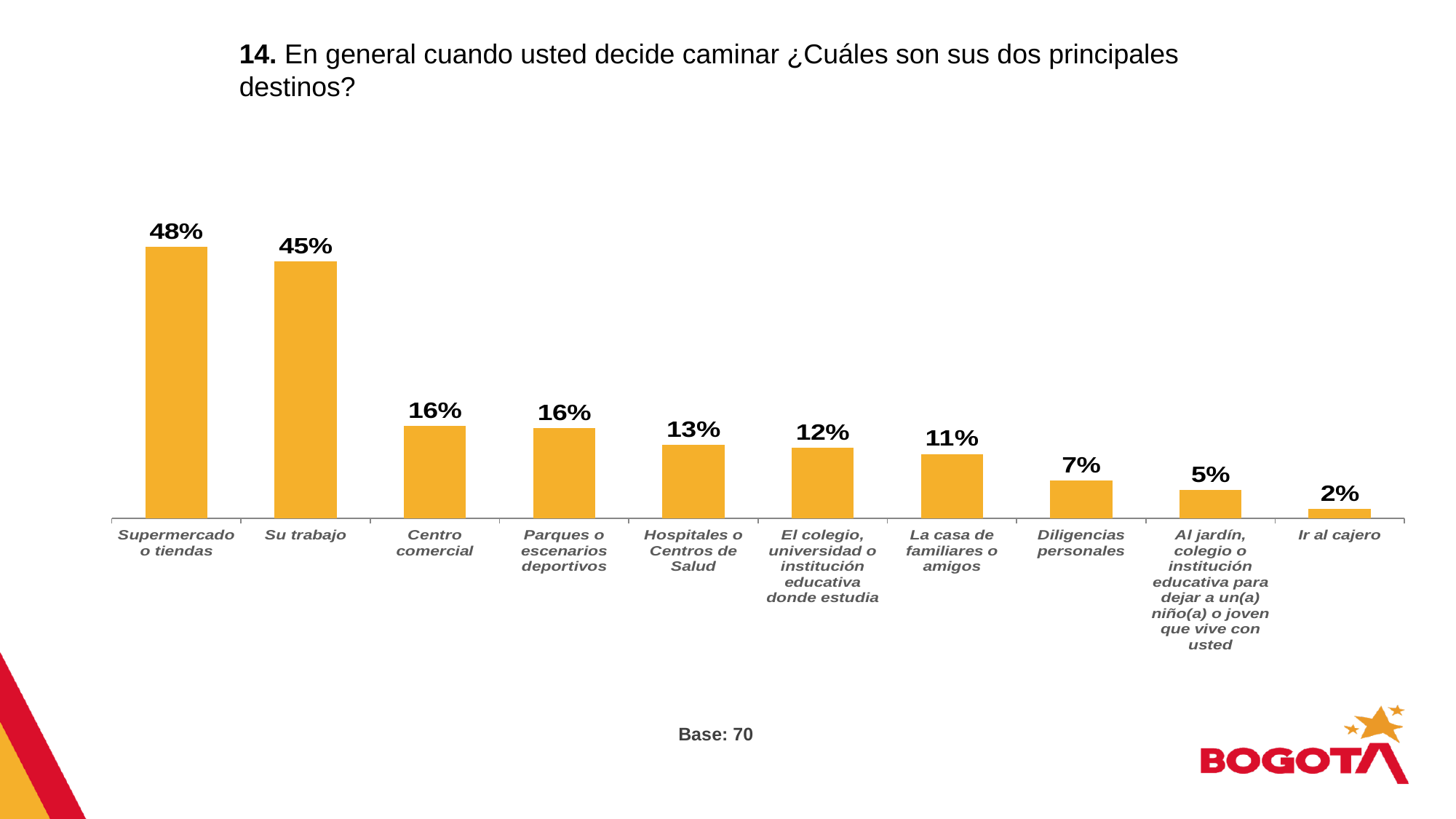
What is the value for Diligencias personales? 7% What is the base (number of respondents) shown below the chart? 70 Which category has the lowest value? Ir al cajero What is the value for Su trabajo? 45% What kind of chart is shown on the slide? Bar chart How many categories are shown in the chart? 10 What is the value for Supermercado o tiendas? 48% What is the difference between the values for Supermercado o tiendas and Su trabajo? 3% What is the difference between the values for Centro comercial and Ir al cajero? 14% Which category has the highest value? Supermercado o tiendas Which is larger, the value for La casa de familiares o amigos or the value for Diligencias personales? La casa de familiares o amigos What is the value for Hospitales o Centros de Salud? 13%